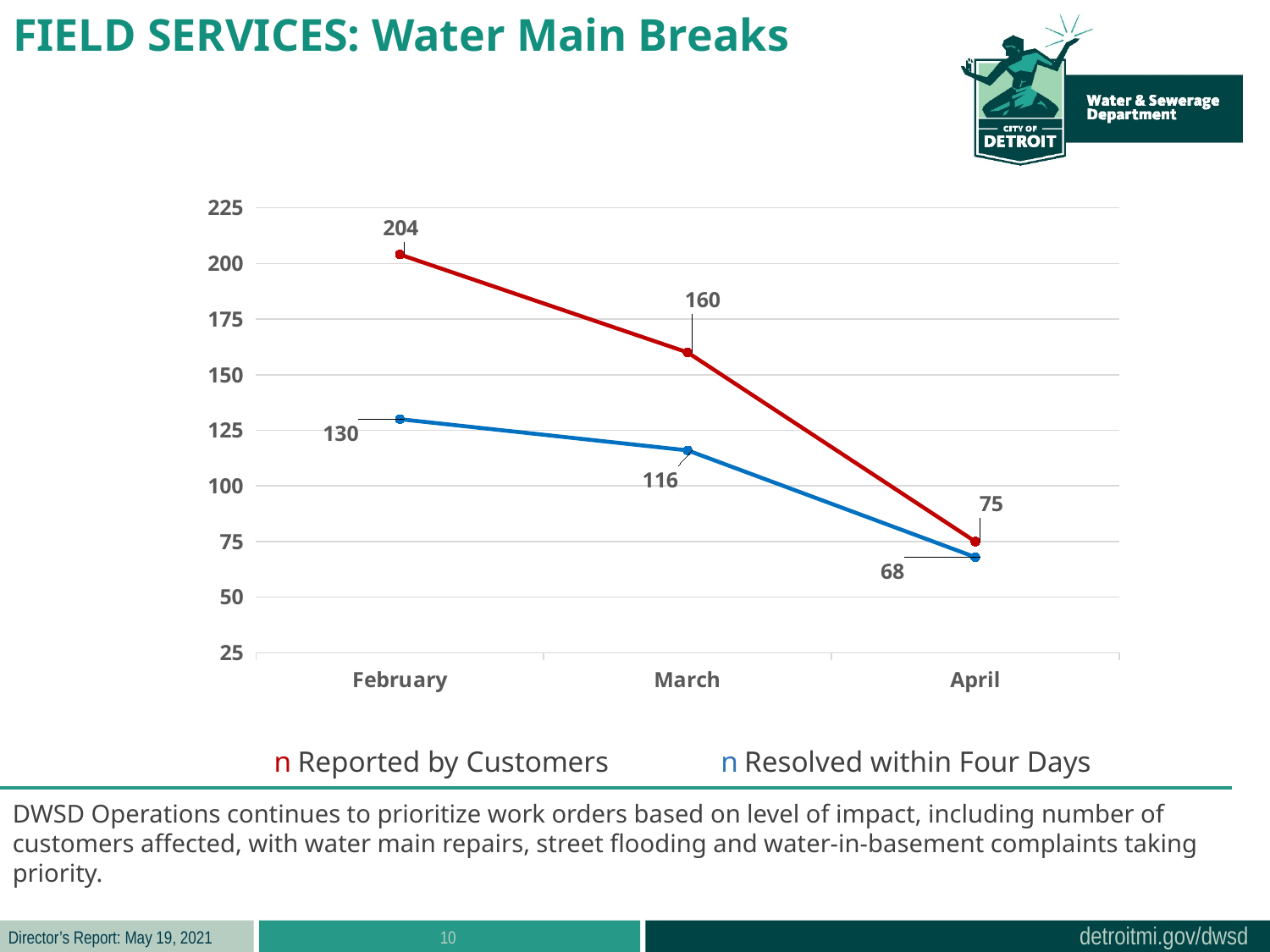
What is the value for Reported by Customers in April? 75 In which month was the number of breaks reported by customers highest? February What colour is the line for Resolved within Four Days? Blue How many water main breaks were resolved within four days in March? 116 Which is larger in February: Reported by Customers or Resolved within Four Days? Reported by Customers In which month was the number resolved within four days lowest? April What kind of chart is shown on the slide? Line chart How many months are shown on the x axis? 3 How many water main breaks were reported by customers in February? 204 Do the values for Reported by Customers rise or fall from February to April? Fall How many series does the legend list? 2 What is the difference between breaks reported by customers and breaks resolved within four days in March? 44